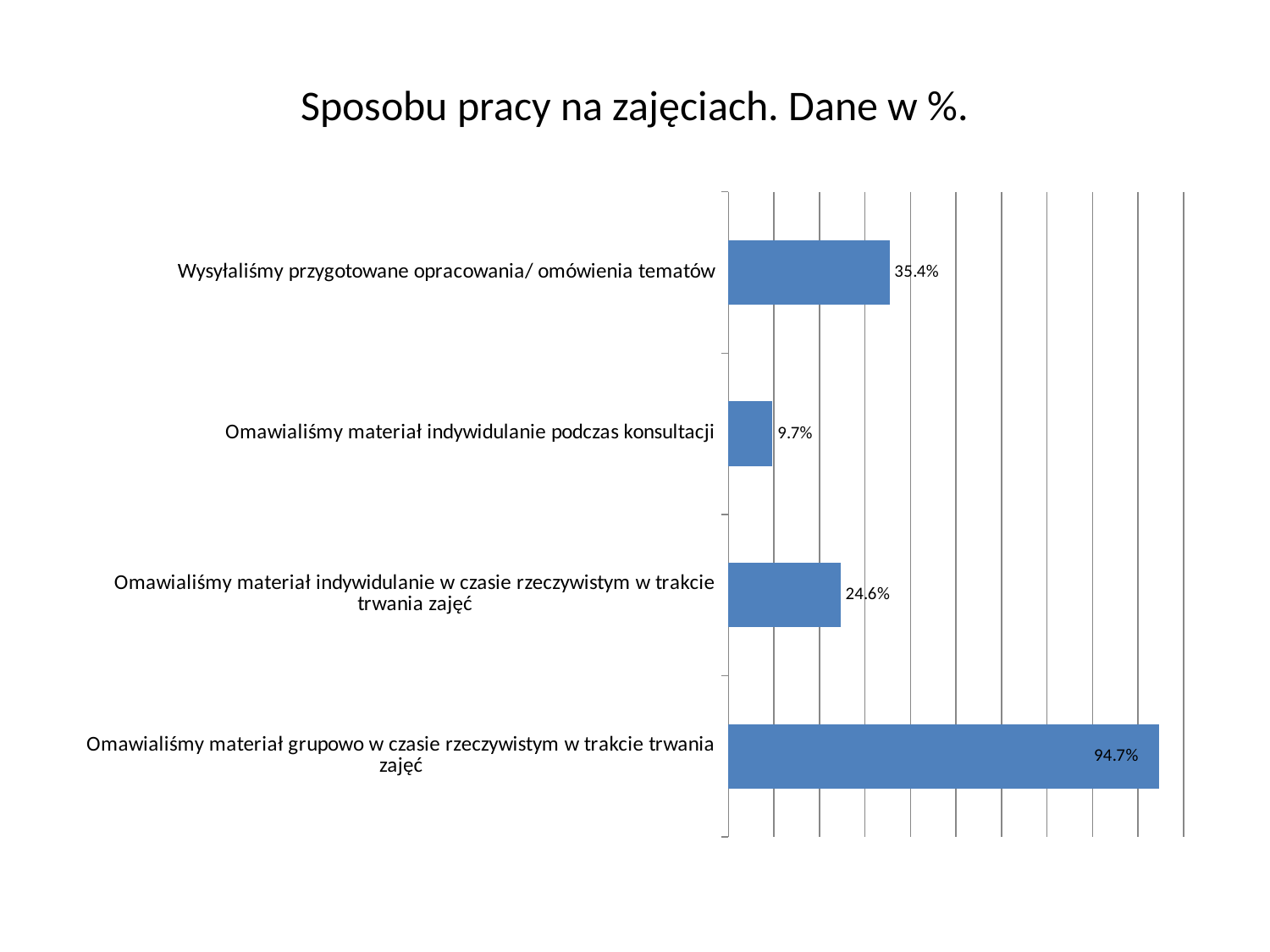
What kind of chart is shown on the slide? Bar chart What is the value for "Omawialiśmy materiał indywidulanie w czasie rzeczywistym w trakcie trwania zajęć"? 24.6% Which category has the lowest value? Omawialiśmy materiał indywidulanie podczas konsultacji How many categories are shown in the chart? 4 Which category has the highest value? Omawialiśmy materiał grupowo w czasie rzeczywistym w trakcie trwania zajęć What is the difference between the values for "Wysyłaliśmy przygotowane opracowania/ omówienia tematów" and "Omawialiśmy materiał indywidulanie w czasie rzeczywistym w trakcie trwania zajęć"? 10.8% What is the title of the chart? Sposobu pracy na zajęciach. Dane w %. What is the value for "Wysyłaliśmy przygotowane opracowania/ omówienia tematów"? 35.4% What is the value for "Omawialiśmy materiał grupowo w czasie rzeczywistym w trakcie trwania zajęć"? 94.7% What is the difference between the values for "Omawialiśmy materiał grupowo w czasie rzeczywistym w trakcie trwania zajęć" and "Wysyłaliśmy przygotowane opracowania/ omówienia tematów"? 59.3% What is the value for "Omawialiśmy materiał indywidulanie podczas konsultacji"? 9.7% Which is larger: the value for "Omawialiśmy materiał indywidulanie podczas konsultacji" or the value for "Omawialiśmy materiał indywidulanie w czasie rzeczywistym w trakcie trwania zajęć"? Omawialiśmy materiał indywidulanie w czasie rzeczywistym w trakcie trwania zajęć